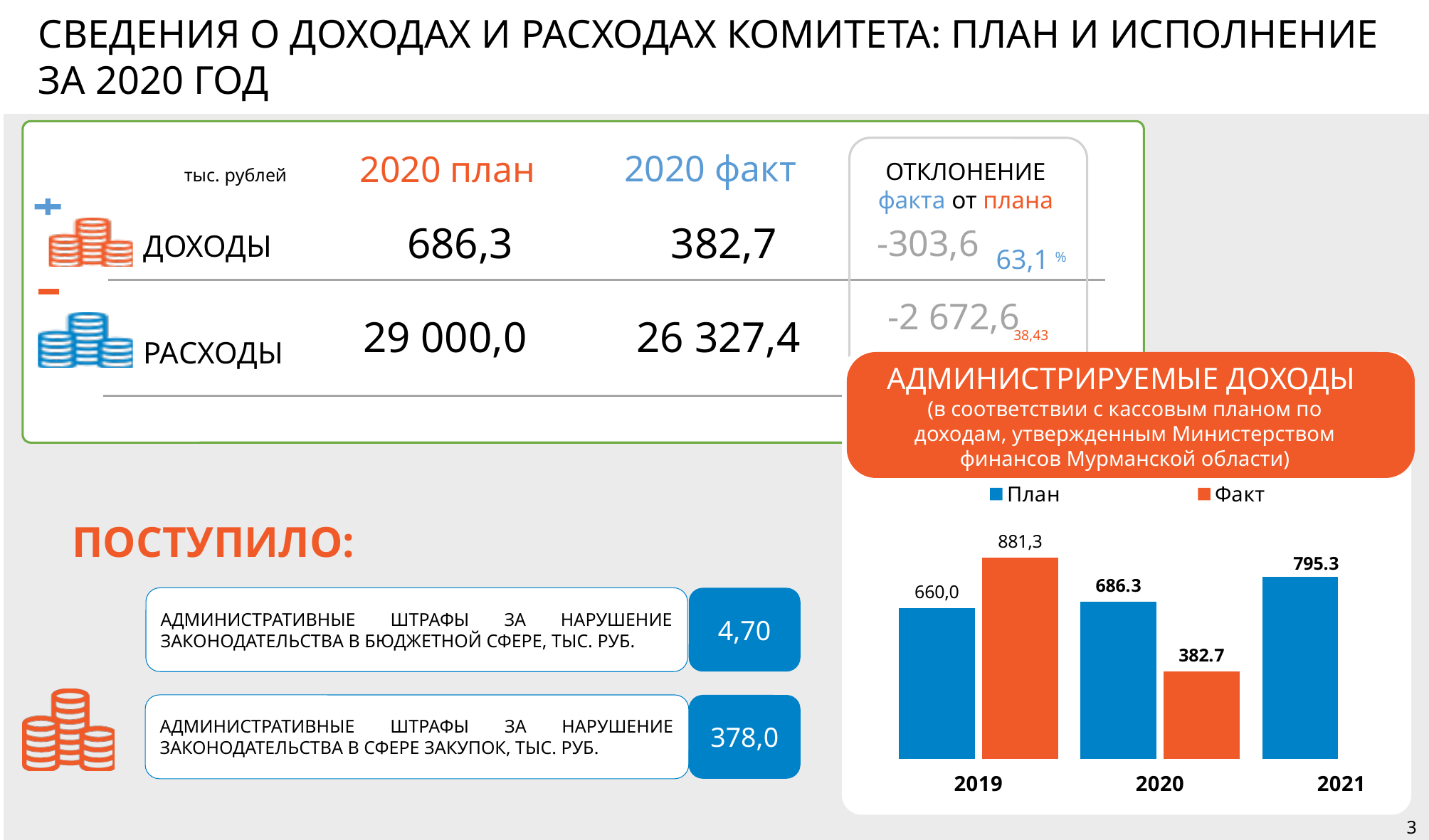
In the АДМИНИСТРИРУЕМЫЕ ДОХОДЫ chart, what is the План value for 2019? 660,0 In the АДМИНИСТРИРУЕМЫЕ ДОХОДЫ chart, what is the Факт value for 2019? 881,3 In the АДМИНИСТРИРУЕМЫЕ ДОХОДЫ chart, what is the difference between the План and Факт values for 2020? 303.6 In the АДМИНИСТРИРУЕМЫЕ ДОХОДЫ chart, what is the Факт value for 2020? 382.7 How many series does the legend of the АДМИНИСТРИРУЕМЫЕ ДОХОДЫ chart list? 2 In the АДМИНИСТРИРУЕМЫЕ ДОХОДЫ chart, which year has the lowest План value? 2019 What type of chart is shown under the heading АДМИНИСТРИРУЕМЫЕ ДОХОДЫ? bar chart In the АДМИНИСТРИРУЕМЫЕ ДОХОДЫ chart, what is the План value for 2021? 795.3 How many years are shown on the x axis of the АДМИНИСТРИРУЕМЫЕ ДОХОДЫ chart? 3 What are the two series named in the legend of the АДМИНИСТРИРУЕМЫЕ ДОХОДЫ chart? План and Факт In the АДМИНИСТРИРУЕМЫЕ ДОХОДЫ chart, which year has the highest Факт value? 2019 In the АДМИНИСТРИРУЕМЫЕ ДОХОДЫ chart, is the Факт value for 2019 larger or smaller than the План value for 2019? larger